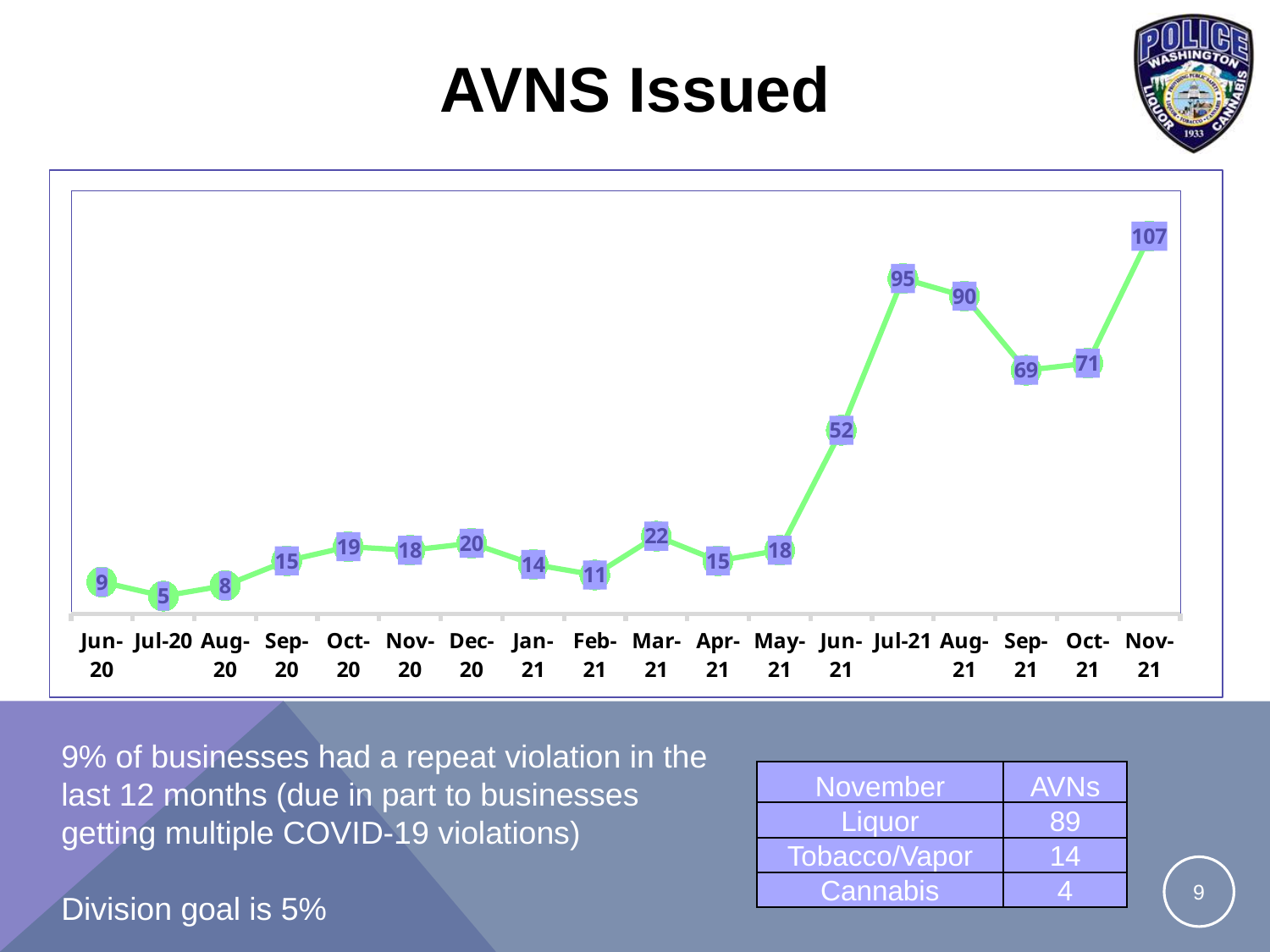
How many data points are plotted on the chart? 18 Which is larger, the value for Sep-21 or the value for Oct-21? Oct-21 Which month has the lowest value? Jul-20 What is the value for Jun-21? 52 What is the difference between the values for Nov-21 and Oct-21? 36 Do the values generally rise or fall from Jun-20 to Nov-21? rise Which month has the highest value? Nov-21 What is the difference between the values for Jul-21 and Aug-21? 5 What is the title of the chart? AVNS Issued What is the value for Mar-21? 22 What is the value for Nov-21? 107 What kind of chart is shown on the slide? line chart